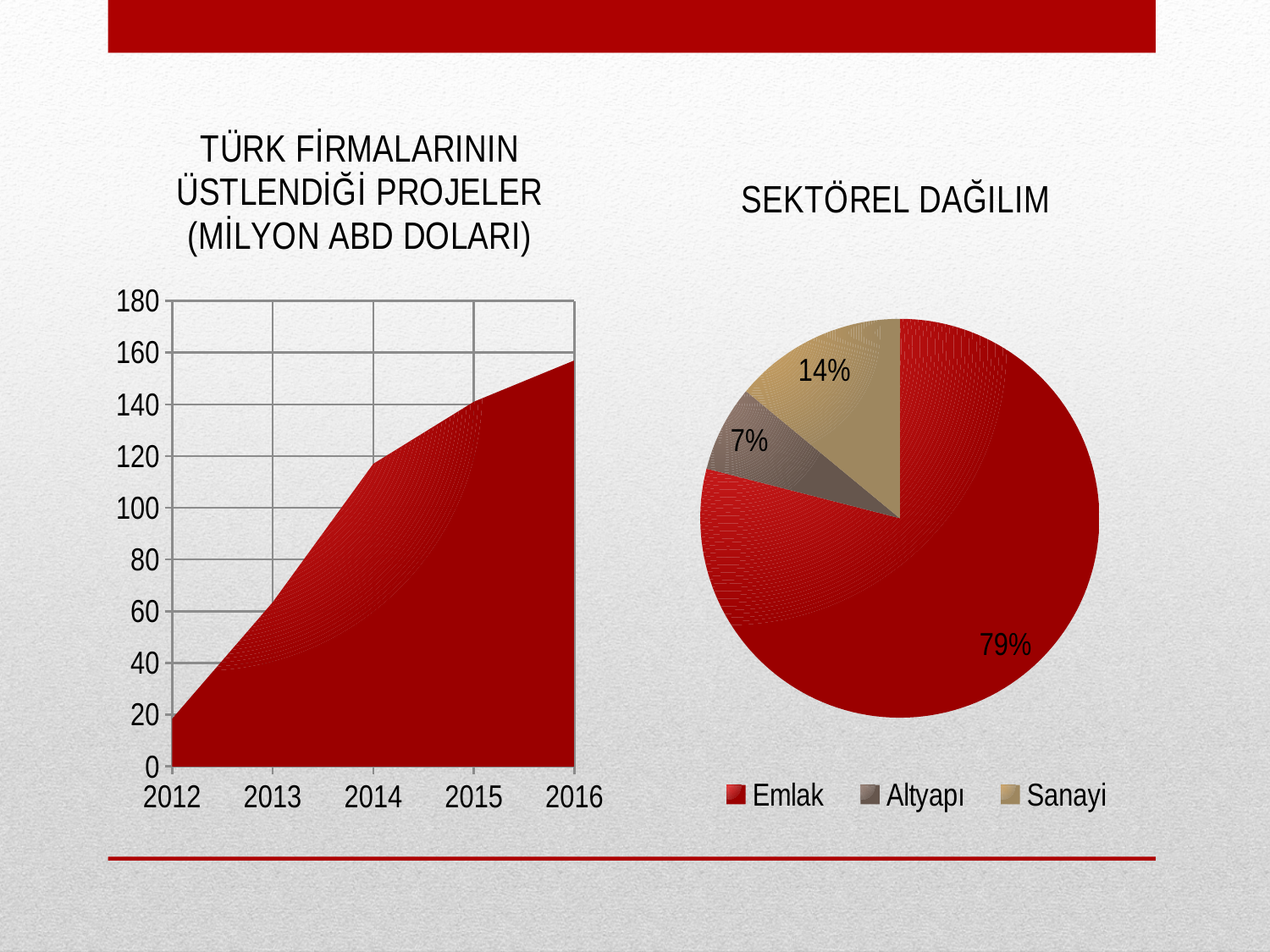
In the pie chart titled SEKTÖREL DAĞILIM, which sector has the smallest share? Altyapı In the pie chart titled SEKTÖREL DAĞILIM, what share does Sanayi have? 14% In the pie chart titled SEKTÖREL DAĞILIM, how many sectors does the legend list? 3 In the pie chart titled SEKTÖREL DAĞILIM, what share does Emlak have? 79% In the pie chart titled SEKTÖREL DAĞILIM, which sector has the largest share? Emlak In the left chart titled TÜRK FİRMALARININ ÜSTLENDİĞİ PROJELER, how many years are shown on the x axis? 5 In the left chart titled TÜRK FİRMALARININ ÜSTLENDİĞİ PROJELER, do the values rise or fall from 2012 to 2016? Rise In the left chart titled TÜRK FİRMALARININ ÜSTLENDİĞİ PROJELER, is the value for 2016 greater or less than 140? greater In the pie chart titled SEKTÖREL DAĞILIM, how many percentage points larger is Sanayi's share than Altyapı's? 7 In the left chart titled TÜRK FİRMALARININ ÜSTLENDİĞİ PROJELER, is the value for 2013 greater or less than 80? less In the pie chart titled SEKTÖREL DAĞILIM, what share does Altyapı have? 7% What kind of chart is the left chart titled TÜRK FİRMALARININ ÜSTLENDİĞİ PROJELER? Area chart